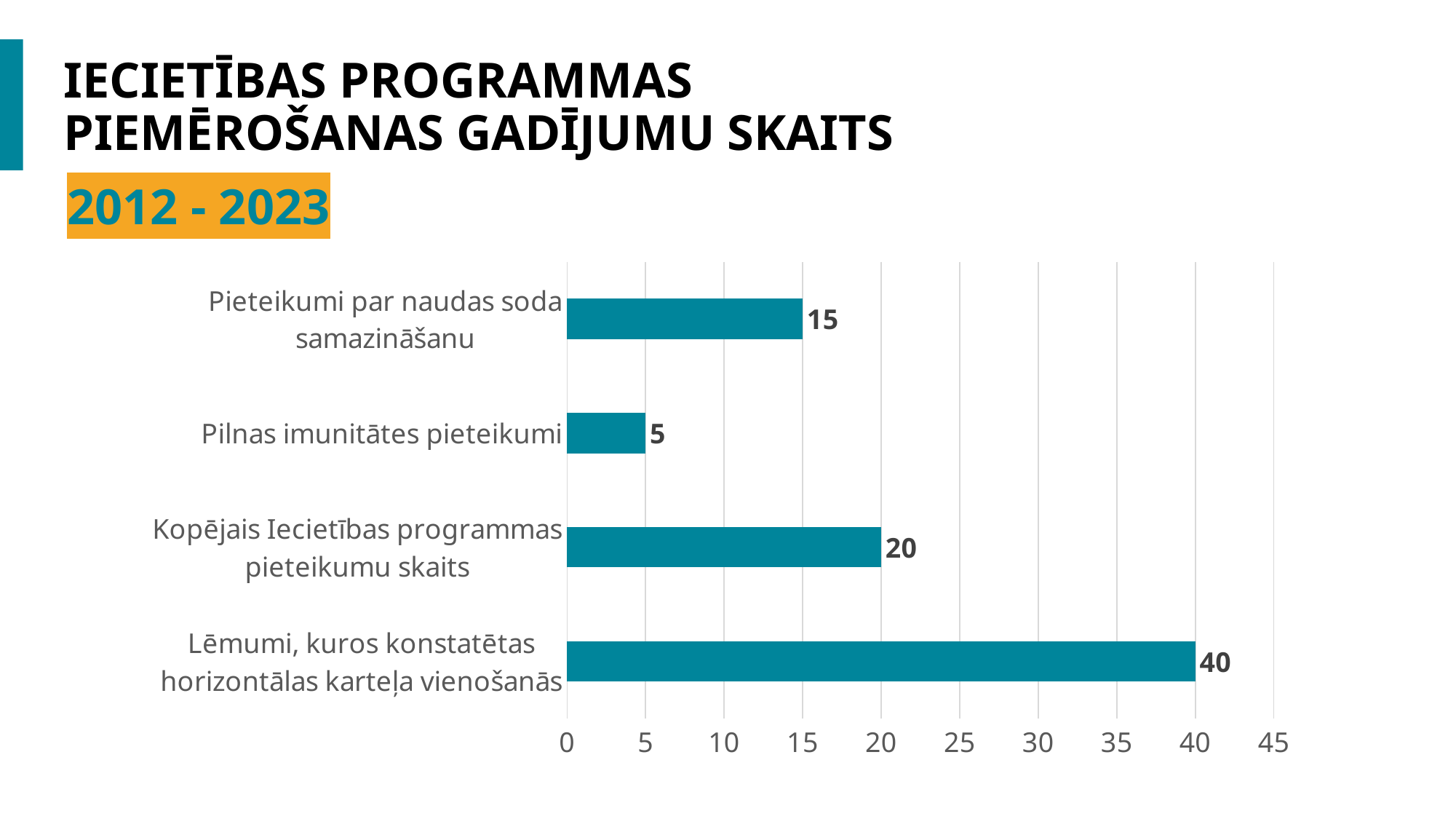
What is the value for "Pieteikumi par naudas soda samazināšanu"? 15 Which is larger: the value for "Pieteikumi par naudas soda samazināšanu" or the value for "Kopējais Iecietības programmas pieteikumu skaits"? Kopējais Iecietības programmas pieteikumu skaits What kind of chart is shown on the slide? Bar chart What is the difference between the value for "Lēmumi, kuros konstatētas horizontālas karteļa vienošanās" and the value for "Kopējais Iecietības programmas pieteikumu skaits"? 20 What is the difference between the value for "Pieteikumi par naudas soda samazināšanu" and the value for "Pilnas imunitātes pieteikumi"? 10 How many categories are shown in the chart? 4 Which category has the lowest value? Pilnas imunitātes pieteikumi What is the value for "Kopējais Iecietības programmas pieteikumu skaits"? 20 What is the value for "Lēmumi, kuros konstatētas horizontālas karteļa vienošanās"? 40 What period is shown in the highlighted label above the chart? 2012 - 2023 What is the value for "Pilnas imunitātes pieteikumi"? 5 Which category has the highest value? Lēmumi, kuros konstatētas horizontālas karteļa vienošanās